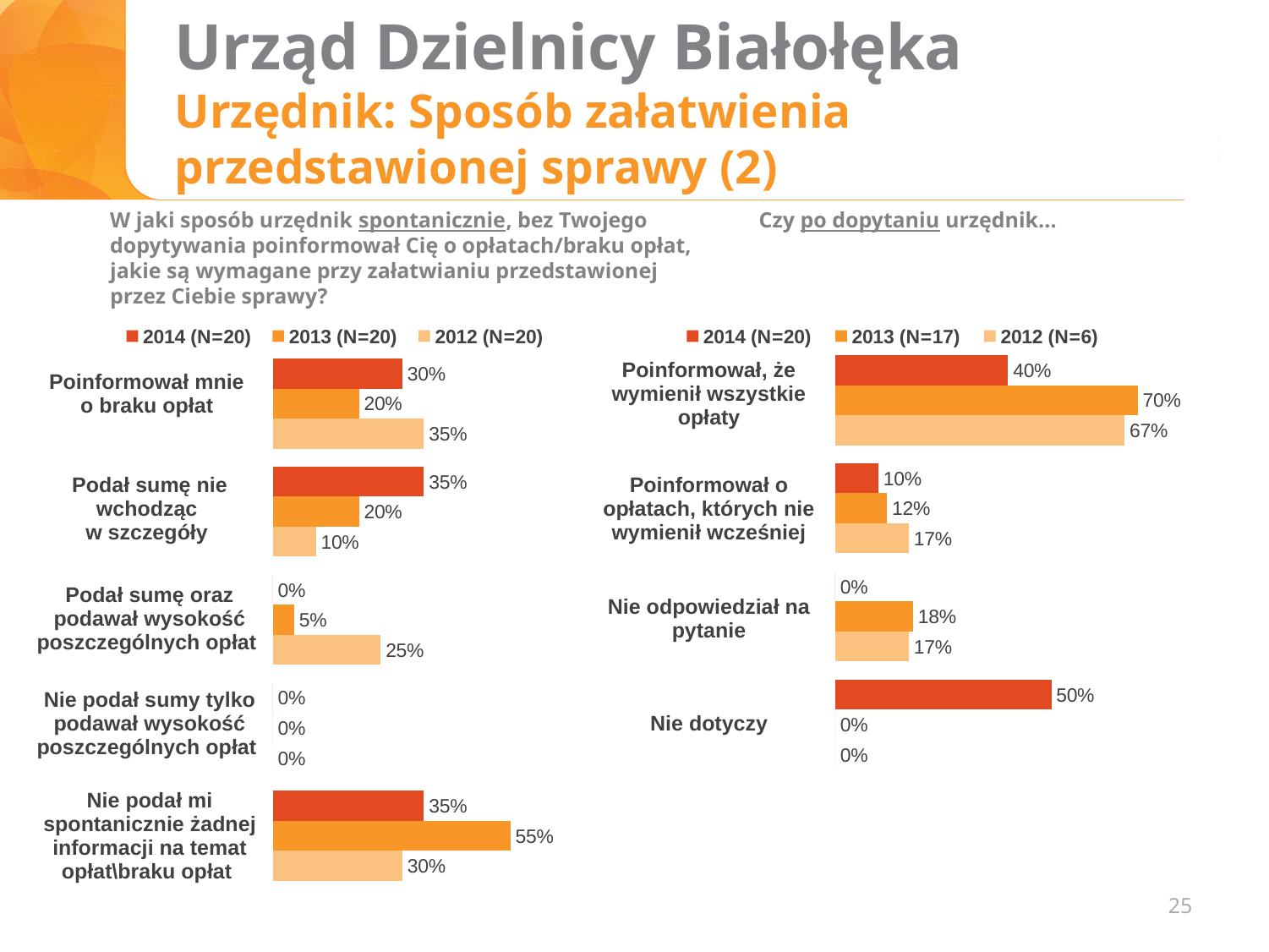
On the left chart, what is the 2013 (N=20) value for 'Nie podał mi spontanicznie żadnej informacji na temat opłat\braku opłat'? 55% On the left chart, which category has the highest 2012 (N=20) value? Poinformował mnie o braku opłat How many categories does the left chart show? 5 On the right chart, what is the 2013 (N=17) value for 'Poinformował, że wymienił wszystkie opłaty'? 70% On the right chart, which category has the lowest 2014 (N=20) value? Nie odpowiedział na pytanie How many categories does the right chart show? 4 How many series does the legend of the right chart list? 3 What type of chart is the left chart? Bar chart On the left chart, what is the difference between the 2013 and 2014 values for 'Nie podał mi spontanicznie żadnej informacji na temat opłat\braku opłat'? 20 percentage points On the right chart, what is the 2014 (N=20) value for 'Nie dotyczy'? 50% On the right chart, which is larger for 'Poinformował o opłatach, których nie wymienił wcześniej': the 2012 (N=6) value or the 2014 (N=20) value? 2012 (N=6) On the left chart, what is the 2014 (N=20) value for 'Poinformował mnie o braku opłat'? 30%